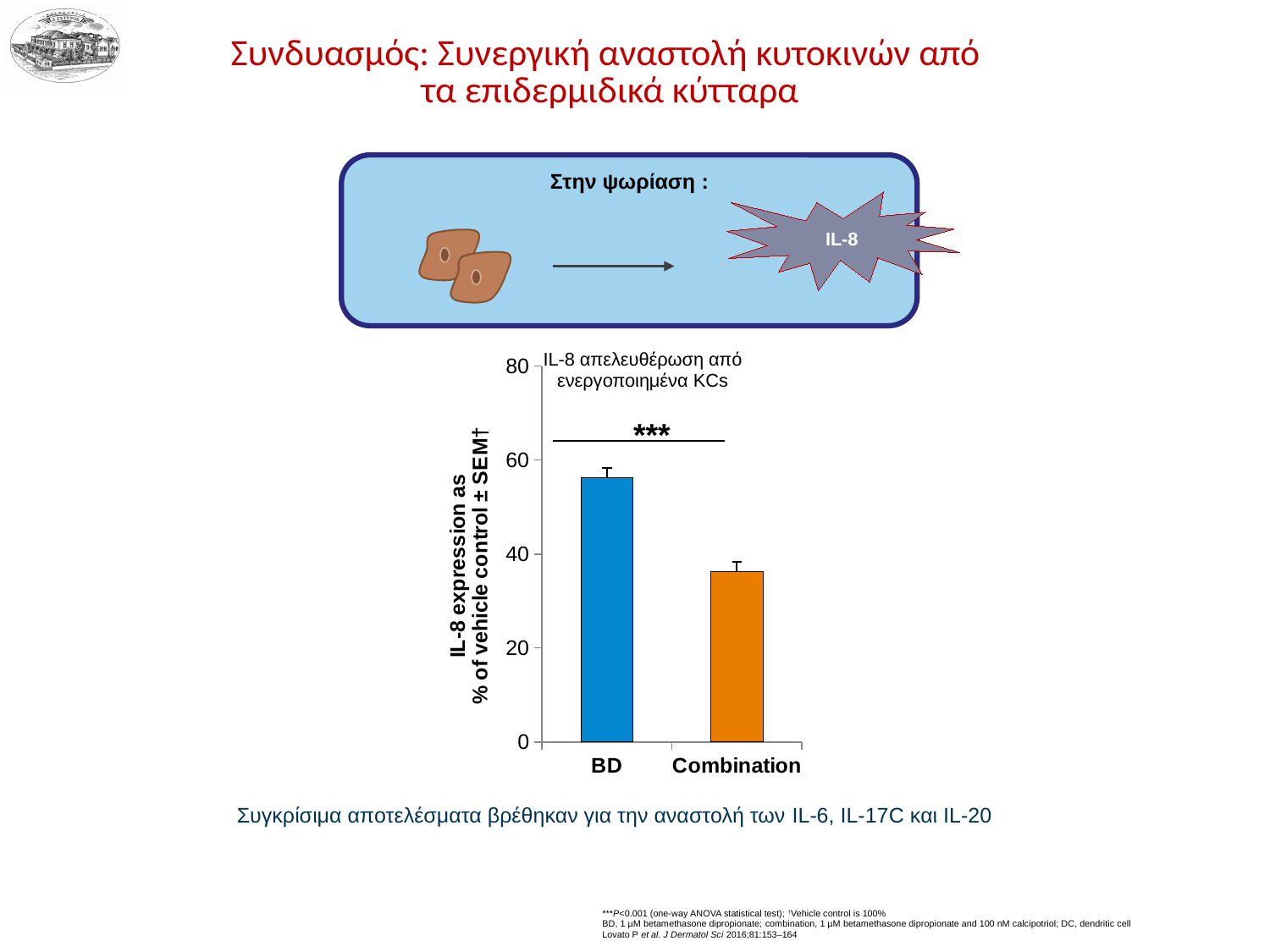
Which category has the lowest IL-8 expression in the chart? Combination Is the value for Combination greater or less than 20? greater Is the value for Combination greater or less than 40? less What kind of chart is shown on the slide? bar chart How many bars are plotted in the chart? 2 Is the value for BD greater or less than 40? greater What is the label of the y axis of the chart? IL-8 expression as % of vehicle control ± SEM† Which category has the highest IL-8 expression in the chart? BD Which bar is taller, BD or Combination? BD What is the title of the chart? IL-8 απελευθέρωση από ενεργοποιημένα KCs